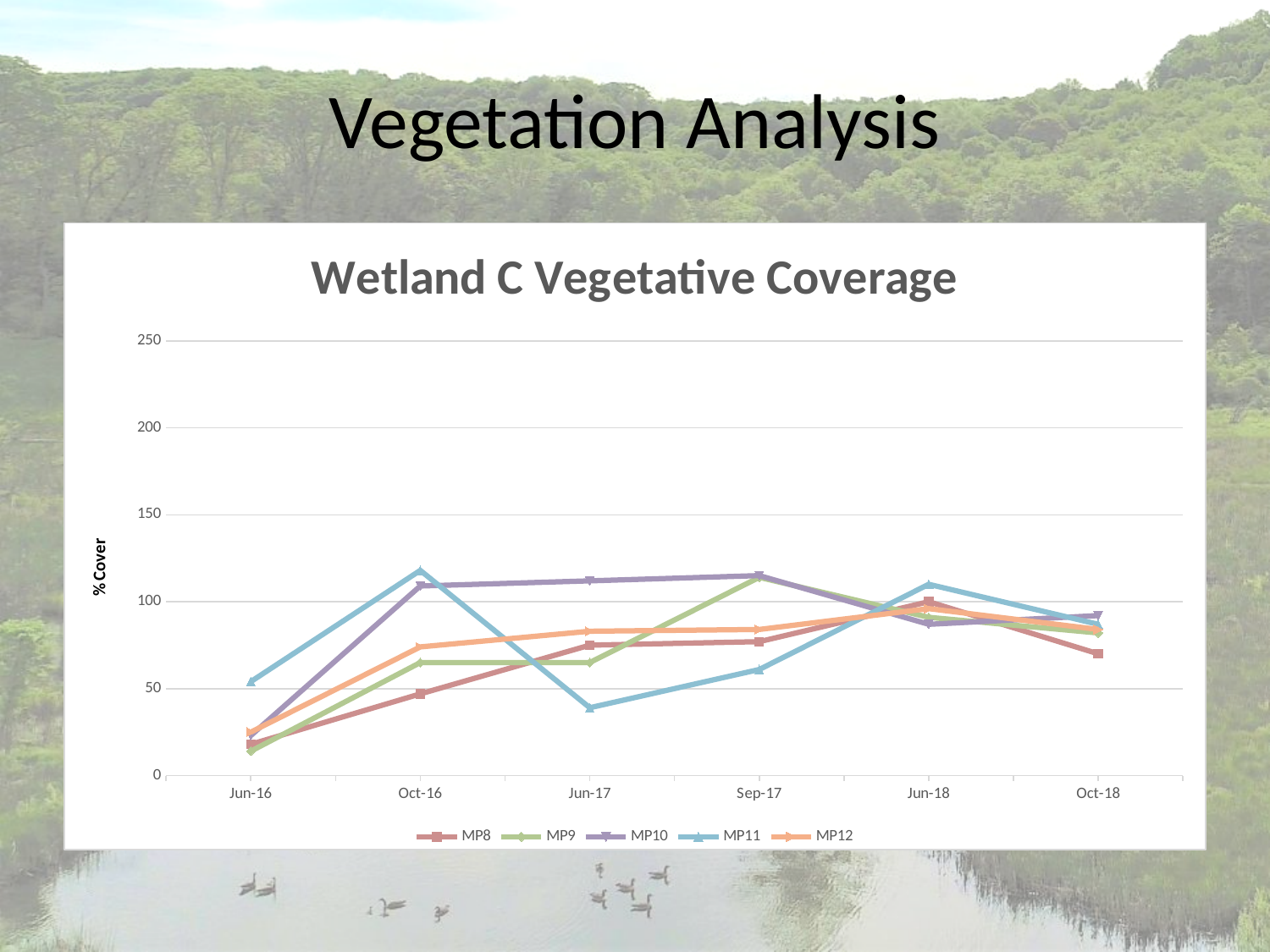
How many time points are shown on the x axis? 6 How many series does the legend list? 5 What kind of chart is shown on the slide? line chart What is the label of the y axis? % Cover Is the value for MP11 at Jun-17 greater or less than 50? less Which series has the lowest value at Jun-17? MP11 At Jun-17, which is larger, the value for MP10 or the value for MP11? MP10 What is the title of the chart? Wetland C Vegetative Coverage Is the value for MP9 at Sep-17 greater or less than 100? greater Is the value for MP10 at Oct-16 greater or less than 100? greater Which series has the highest value at Jun-16? MP11